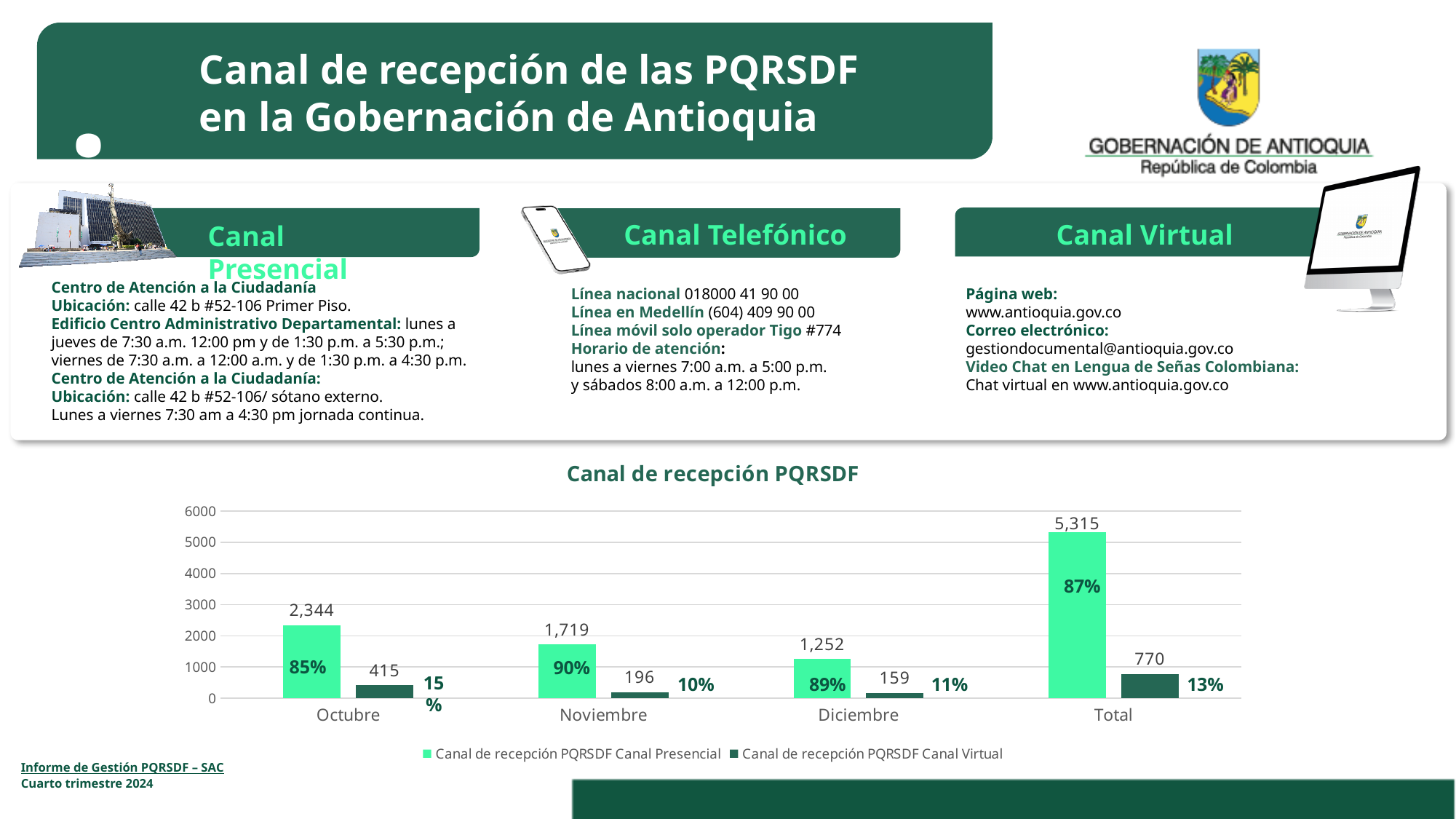
What type of chart is shown under the title "Canal de recepción PQRSDF"? bar chart What percentage label is shown on the Canal Presencial bar for Noviembre? 90% Do the Canal Virtual values rise or fall from Octubre to Diciembre? fall What is the value for Canal Presencial in Octubre? 2,344 Among Octubre, Noviembre and Diciembre, which month has the lowest value for Canal Presencial? Diciembre What is the value for Canal Presencial in Diciembre? 1,252 How many series does the legend of the chart list? 2 What is the value for Canal Virtual in Noviembre? 196 What is the Total value for Canal Virtual? 770 Which is larger in Diciembre, the Canal Presencial value or the Canal Virtual value? Canal Presencial What is the difference between the Canal Presencial and Canal Virtual values in Octubre? 1,929 How many categories are shown on the x axis of the chart? 4